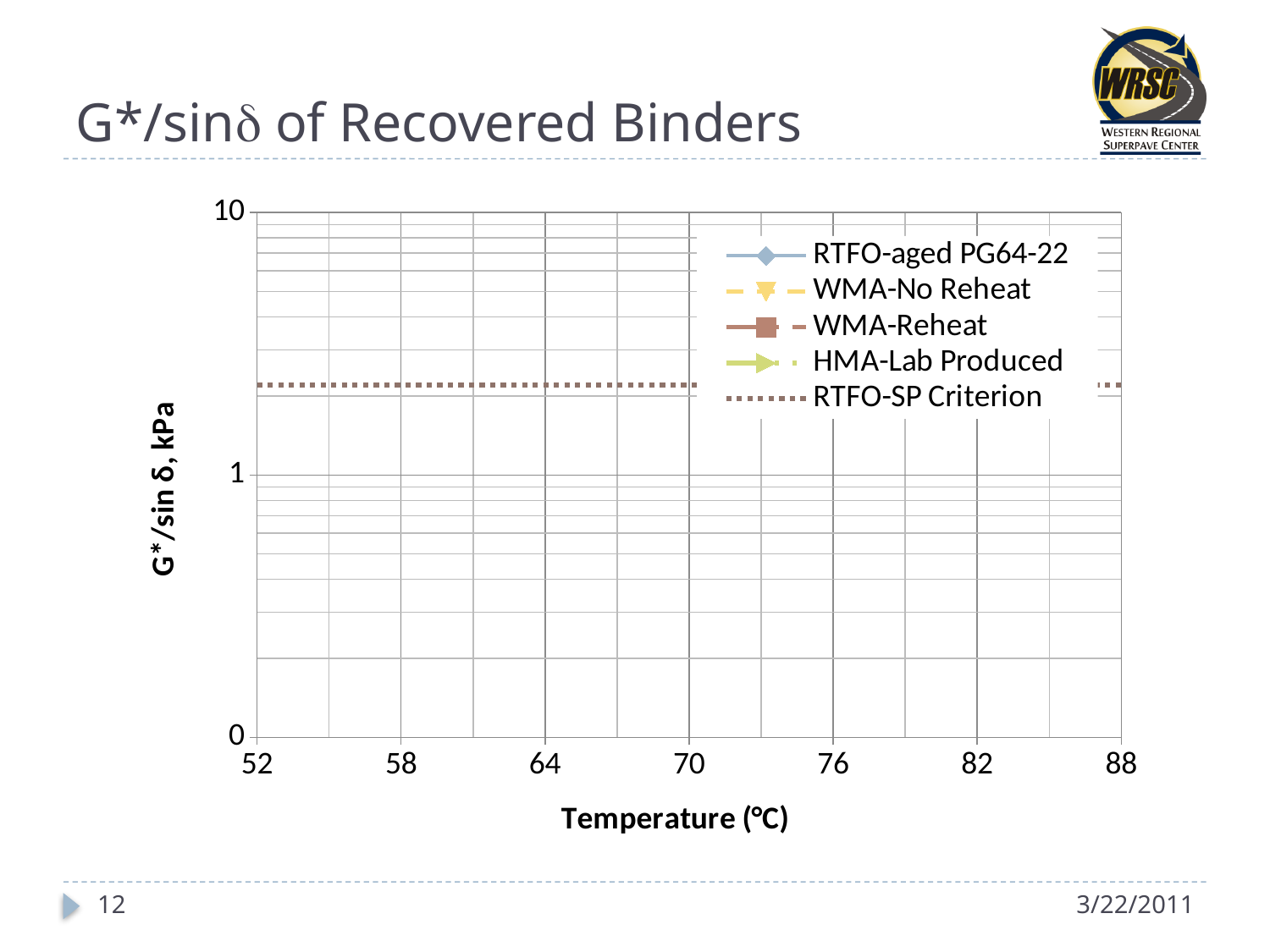
What is the lowest temperature shown on the x axis? 52 Which legend entry is drawn as a dotted line? RTFO-SP Criterion Does the RTFO-SP Criterion line rise, fall, or stay flat as temperature increases along the x axis? stays flat Is the value of the RTFO-SP Criterion line greater or less than 1 kPa? greater What is the highest temperature shown on the x axis? 88 What is the label of the x axis? Temperature (°C) How many series does the chart legend list? 5 What is the title of the slide's chart? G*/sinδ of Recovered Binders What kind of chart is shown on the slide? line chart Is the value of the RTFO-SP Criterion line greater or less than 10 kPa? less How many temperature tick labels are shown on the x axis? 7